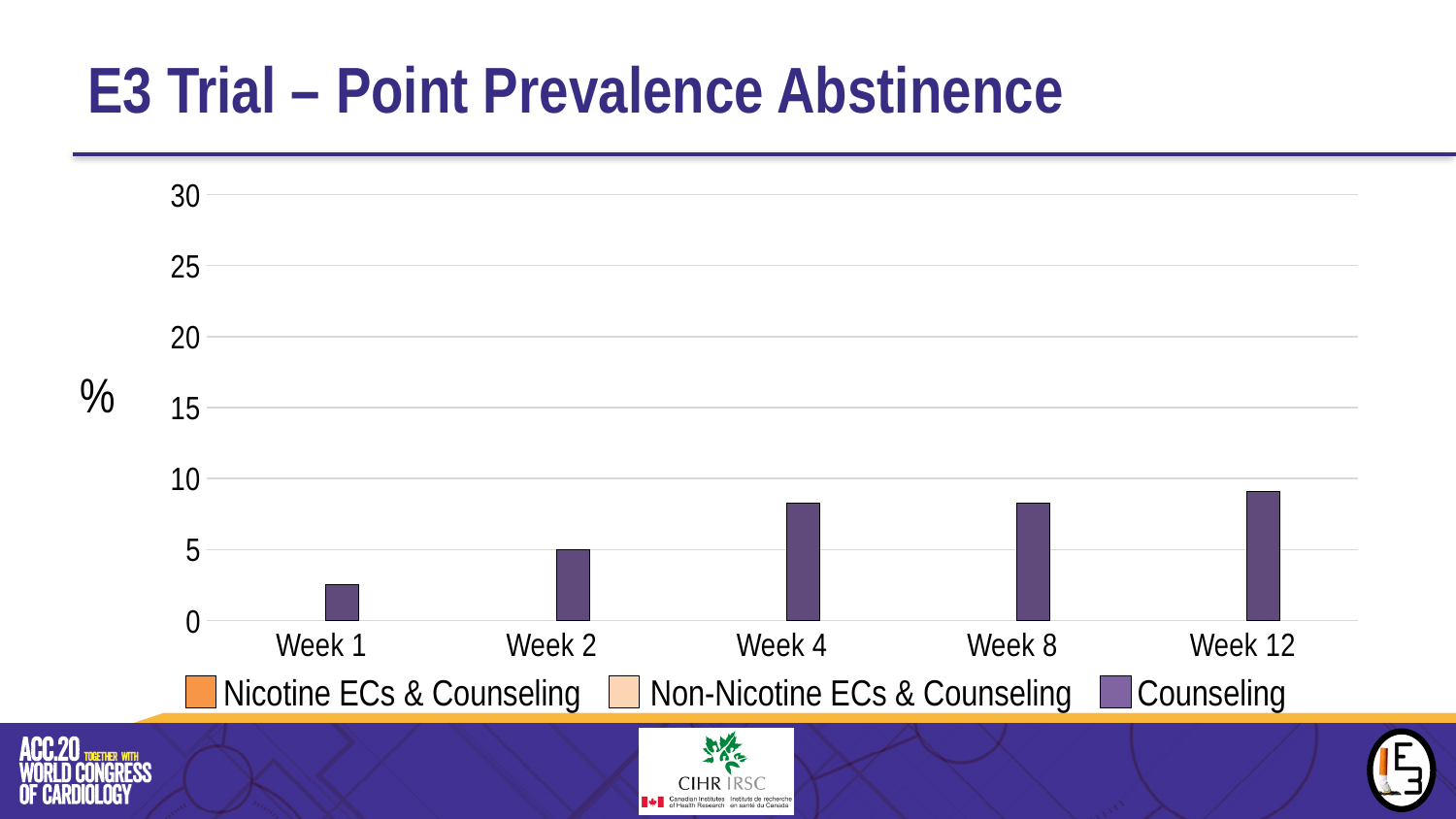
How many week categories are shown on the x axis? 5 Which week has the highest Counseling bar? Week 12 What is the label on the y axis? % Is the Counseling value for Week 1 greater or less than 5? less How many series does the legend list? 3 What is the title of the chart? E3 Trial – Point Prevalence Abstinence Is the Counseling value for Week 12 greater or less than 10? less Do the Counseling bars generally rise or fall from Week 1 to Week 12? rise What kind of chart is shown on the slide? bar chart Which week has the lowest Counseling bar? Week 1 Which is larger, the Counseling bar for Week 2 or for Week 1? Week 2 Is the Counseling value for Week 4 greater or less than 5? greater